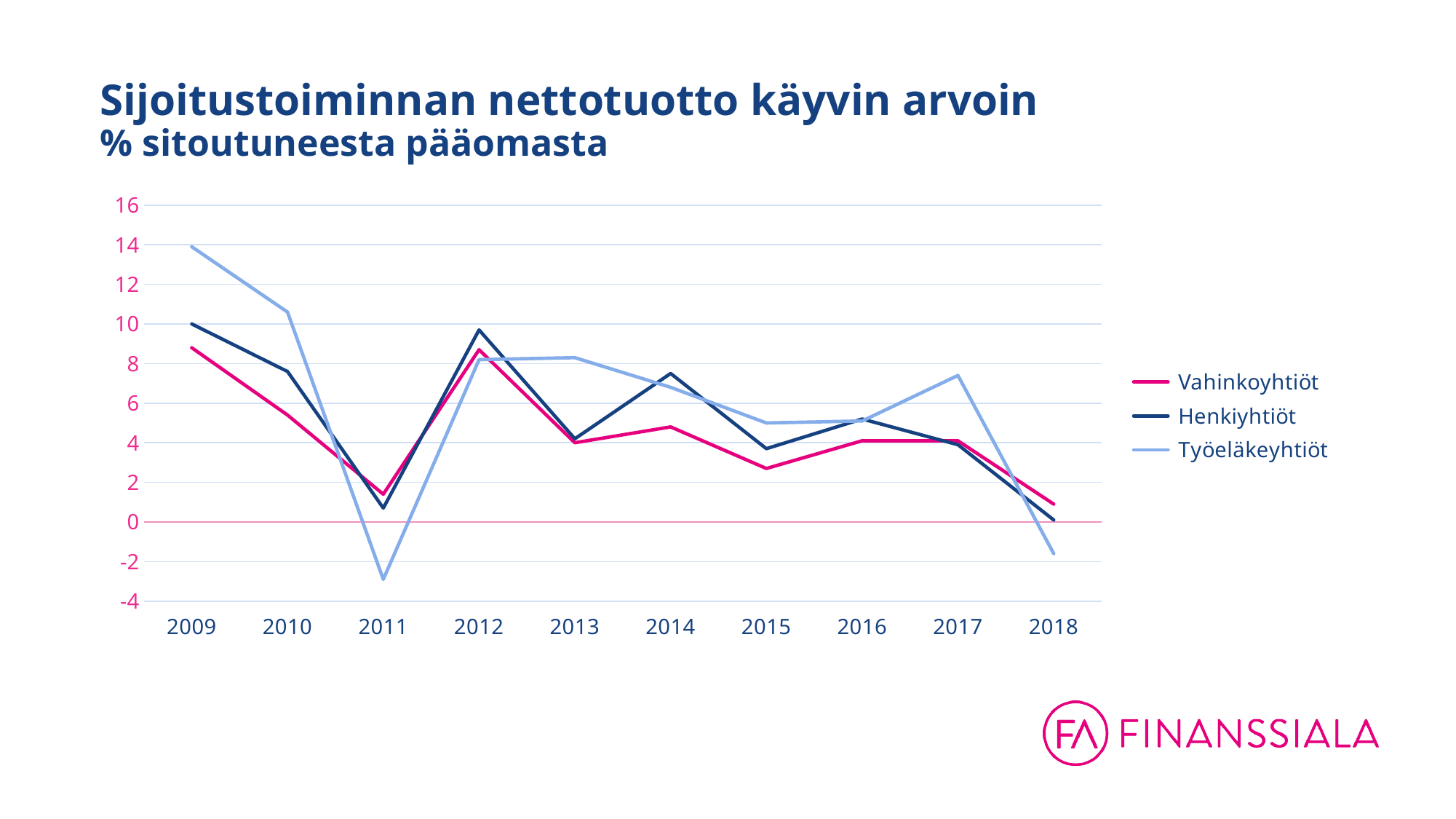
In 2014, which is larger: Henkiyhtiöt or Vahinkoyhtiöt? Henkiyhtiöt How many years are shown on the x axis? 10 Is the value for Työeläkeyhtiöt in 2009 greater or less than 12? greater In which year is the value for Työeläkeyhtiöt highest? 2009 What kind of chart is shown on the slide? line chart In which year is the value for Työeläkeyhtiöt lowest? 2011 How many series does the legend list? 3 Is the value for Työeläkeyhtiöt in 2011 greater or less than 0? less Is the value for Henkiyhtiöt in 2012 greater or less than 8? greater What are the three series named in the legend? Vahinkoyhtiöt, Henkiyhtiöt, Työeläkeyhtiöt Does the value for Vahinkoyhtiöt rise or fall from 2009 to 2011? fall